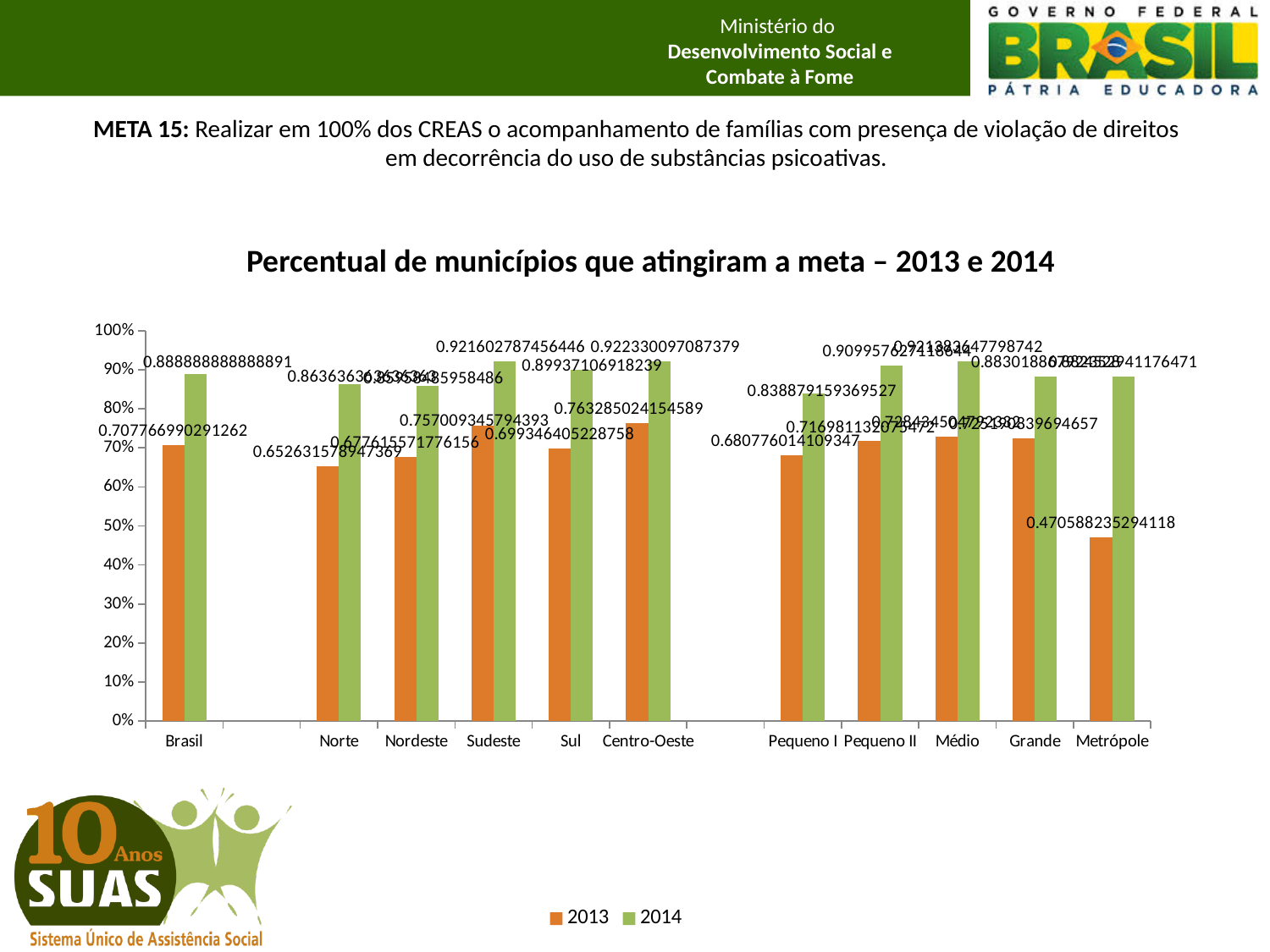
What is the value for Centro-Oeste in 2014? 0.922330097087379 Is the 2013 value for Metrópole greater or less than 50%? less What is the value for Brasil in 2013? 0.707766990291262 What is the value for Pequeno I in 2013? 0.680776014109347 Which is larger for Sul: the 2013 value or the 2014 value? 2014 Which category has the lowest value in the 2013 series? Metrópole How many series does the legend list? 2 How many categories are shown on the x axis? 11 What is the value for Metrópole in 2013? 0.470588235294118 Which colour represents the 2014 series in the legend? Green What is the value for Brasil in 2014? 0.888888888888891 What kind of chart is shown on the slide? Bar chart